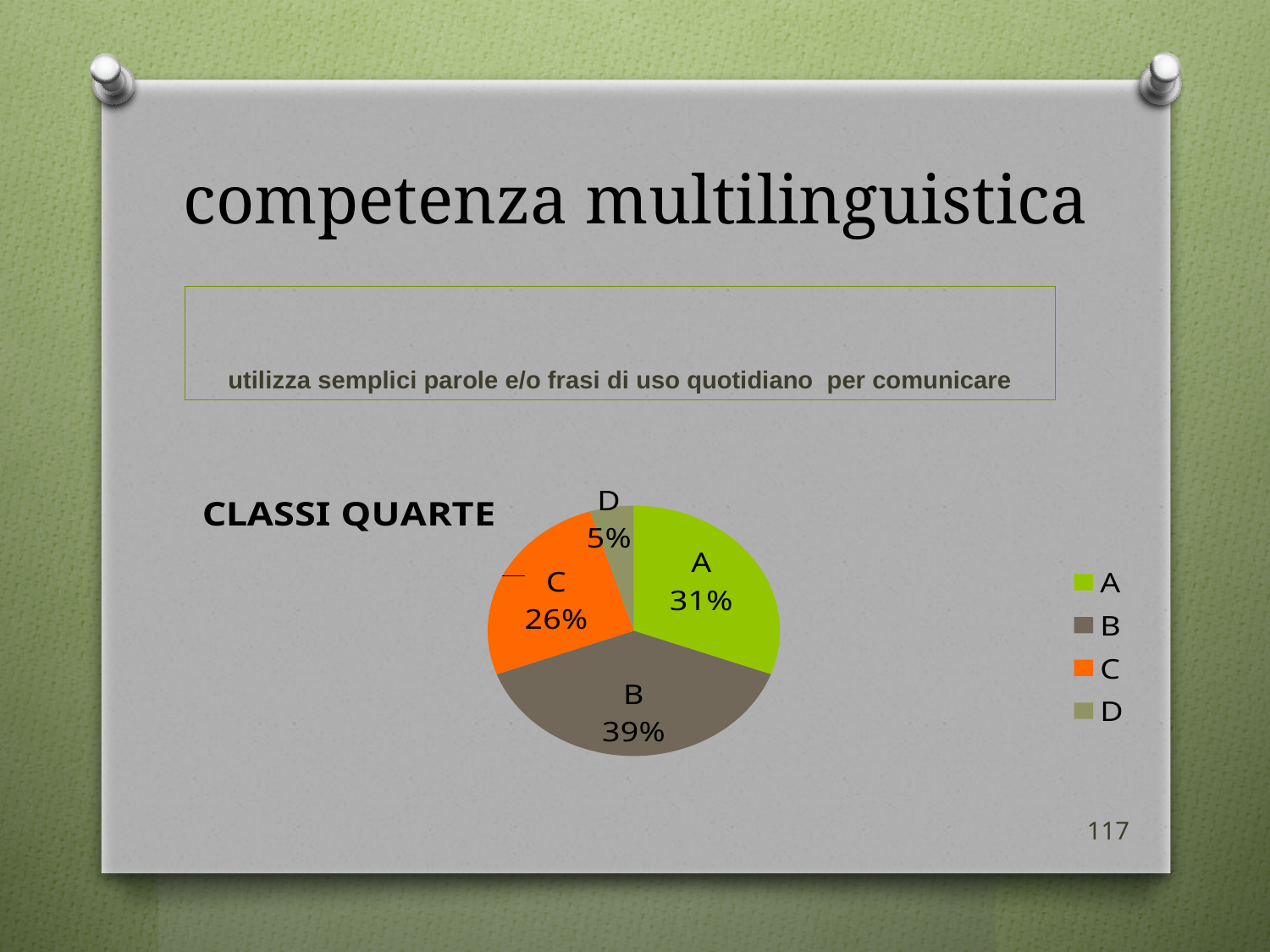
Which is larger, slice A or slice C? A What is the difference in percentage points between slice B and slice A? 8 Which slice of the pie chart is the largest? B How many slices does the pie chart have? 4 What percentage does slice D represent in the pie chart? 5% How many entries does the legend list? 4 What type of chart is shown on the slide? pie chart What percentage does slice B represent in the pie chart? 39% What percentage does slice A represent in the pie chart? 31% Which slice of the pie chart is the smallest? D What colour is slice C in the pie chart? orange What percentage does slice C represent in the pie chart? 26%